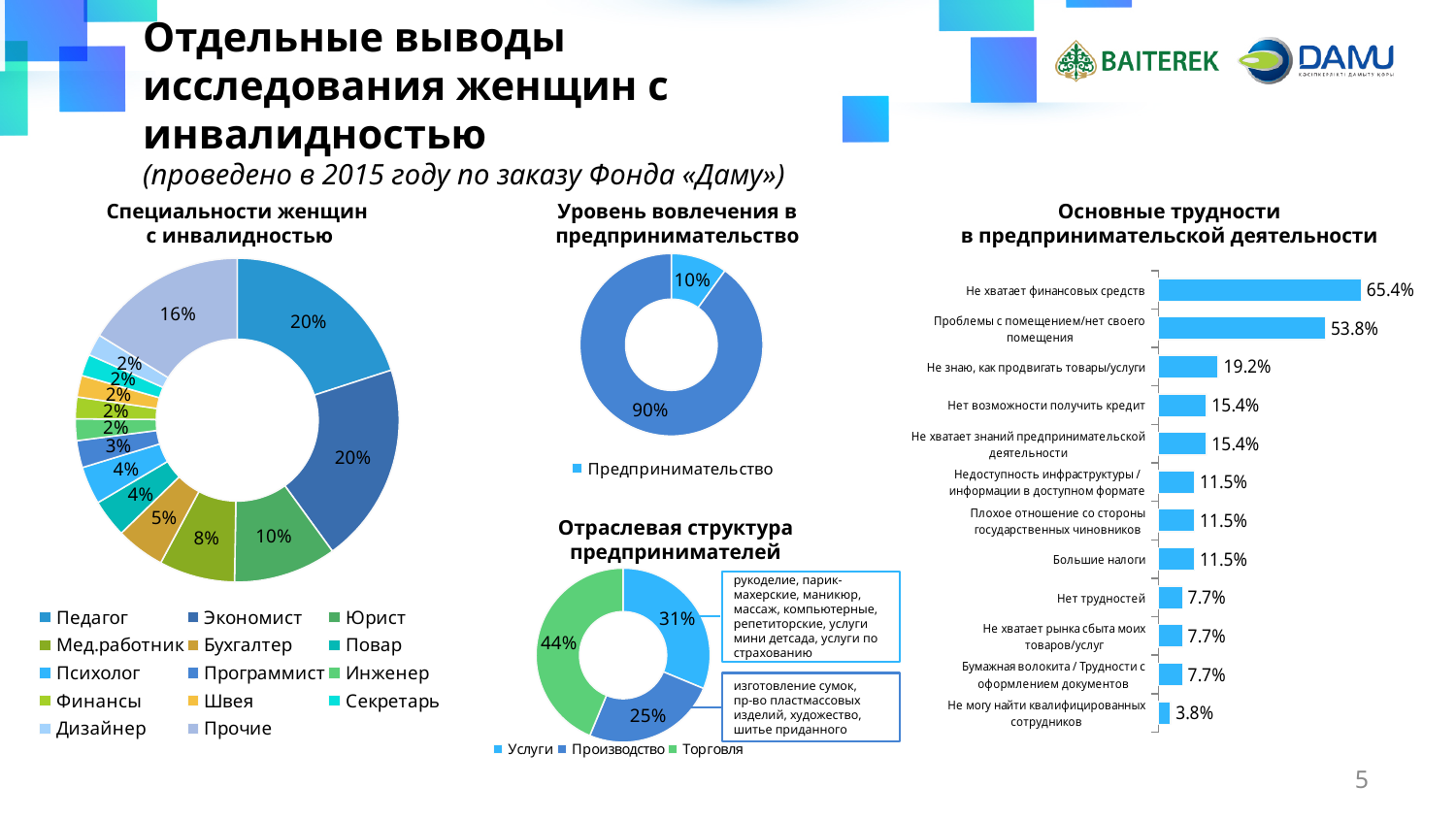
In the chart 'Основные трудности в предпринимательской деятельности', what is the value for 'Не знаю, как продвигать товары/услуги'? 19.2% In the chart 'Уровень вовлечения в предпринимательство', what is the share for 'Предпринимательство'? 10% In the chart 'Отраслевая структура предпринимателей', what is the share for 'Торговля'? 44% How many series does the legend of the chart 'Отраслевая структура предпринимателей' list? 3 In the chart 'Основные трудности в предпринимательской деятельности', what is the value for 'Не хватает финансовых средств'? 65.4% In the chart 'Специальности женщин с инвалидностью', what is the share for 'Юрист'? 10% What kind of chart is 'Основные трудности в предпринимательской деятельности'? Bar chart How many categories does the legend of the chart 'Специальности женщин с инвалидностью' list? 14 How many categories are shown in the chart 'Основные трудности в предпринимательской деятельности'? 12 In the chart 'Основные трудности в предпринимательской деятельности', which category has the lowest value? Не могу найти квалифицированных сотрудников In the chart 'Отраслевая структура предпринимателей', which is larger: 'Услуги' or 'Производство'? Услуги In the chart 'Основные трудности в предпринимательской деятельности', what is the difference between 'Не хватает финансовых средств' and 'Проблемы с помещением/нет своего помещения'? 11.6%